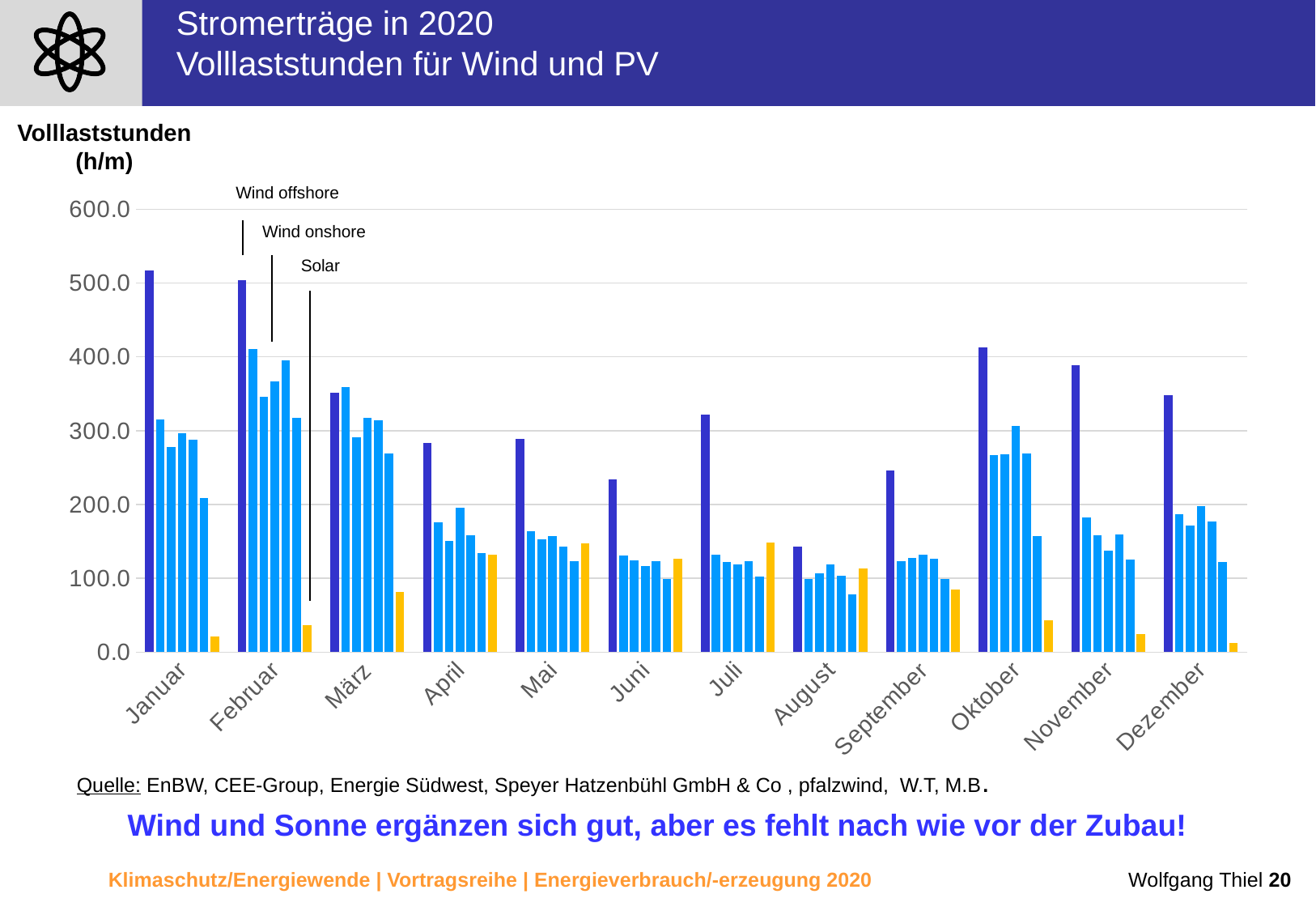
Is the Wind offshore value for August greater or less than 200? less Is the Wind offshore value for Februar greater or less than 400? greater Is the Solar value for Juli greater or less than 100? greater How many months are shown on the x axis of the chart? 12 Which month has the lowest Wind offshore value? August What kind of chart is shown on the slide? bar chart What are the three series named in the chart's legend? Wind offshore, Wind onshore, Solar What is the label of the chart's y axis? Volllaststunden (h/m) How many series does the chart's legend list? 3 Which is larger, the Wind offshore value for Januar or for Juni? Januar